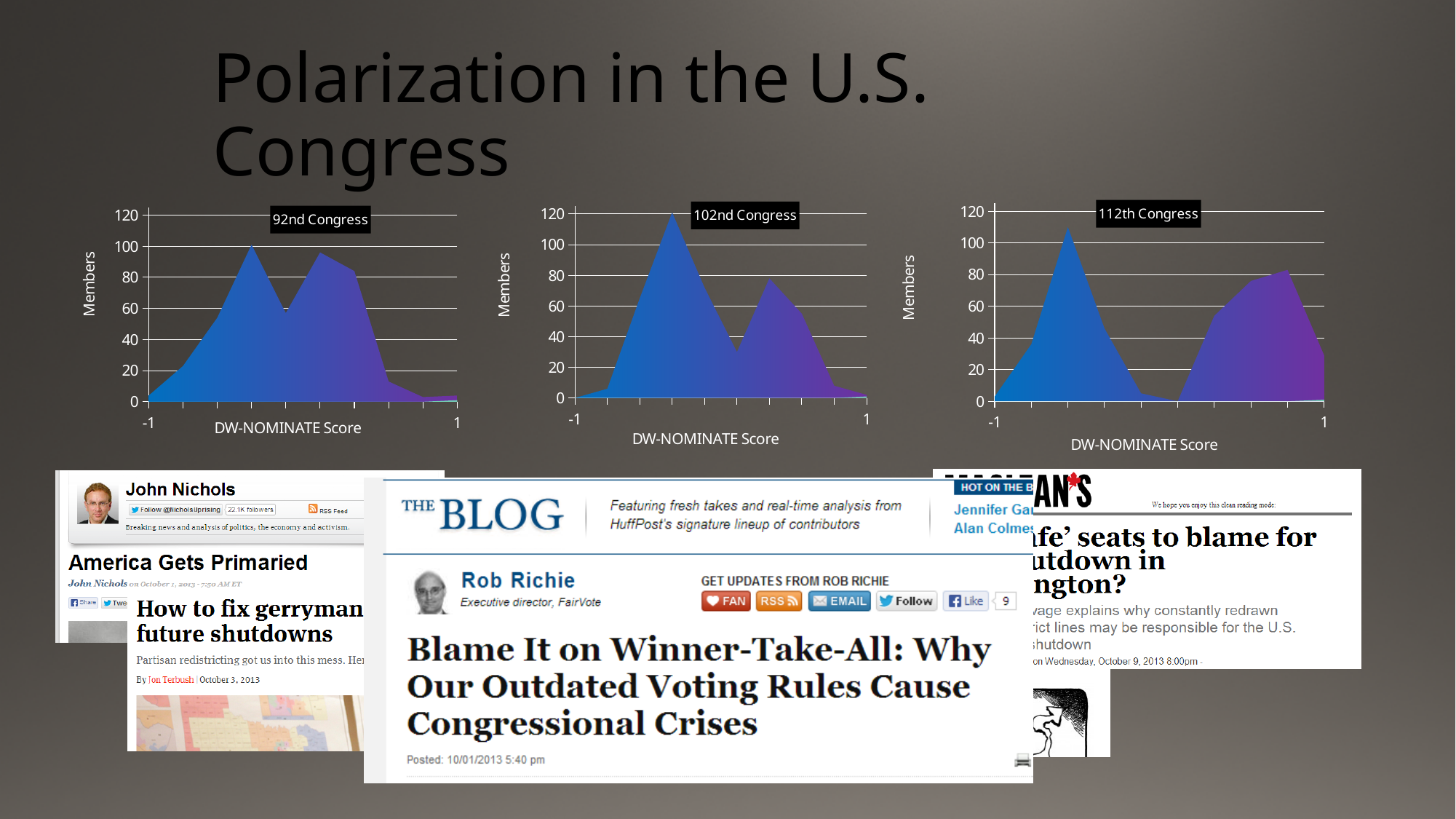
How many charts are shown on the slide? 3 In the 102nd Congress chart, is the peak on the right side greater or less than 100 members? less In the 102nd Congress chart, which peak is higher, the left one or the right one? the left one In the 102nd Congress chart, is the highest peak on the left side greater or less than 100 members? greater In the 112th Congress chart, is the peak on the left side greater or less than 100 members? greater In the 112th Congress chart, which peak is higher, the left one or the right one? the left one What kind of chart is the 92nd Congress chart? area chart What is the label on the horizontal axis of the 112th Congress chart? DW-NOMINATE Score What is the label on the vertical axis of the 102nd Congress chart? Members